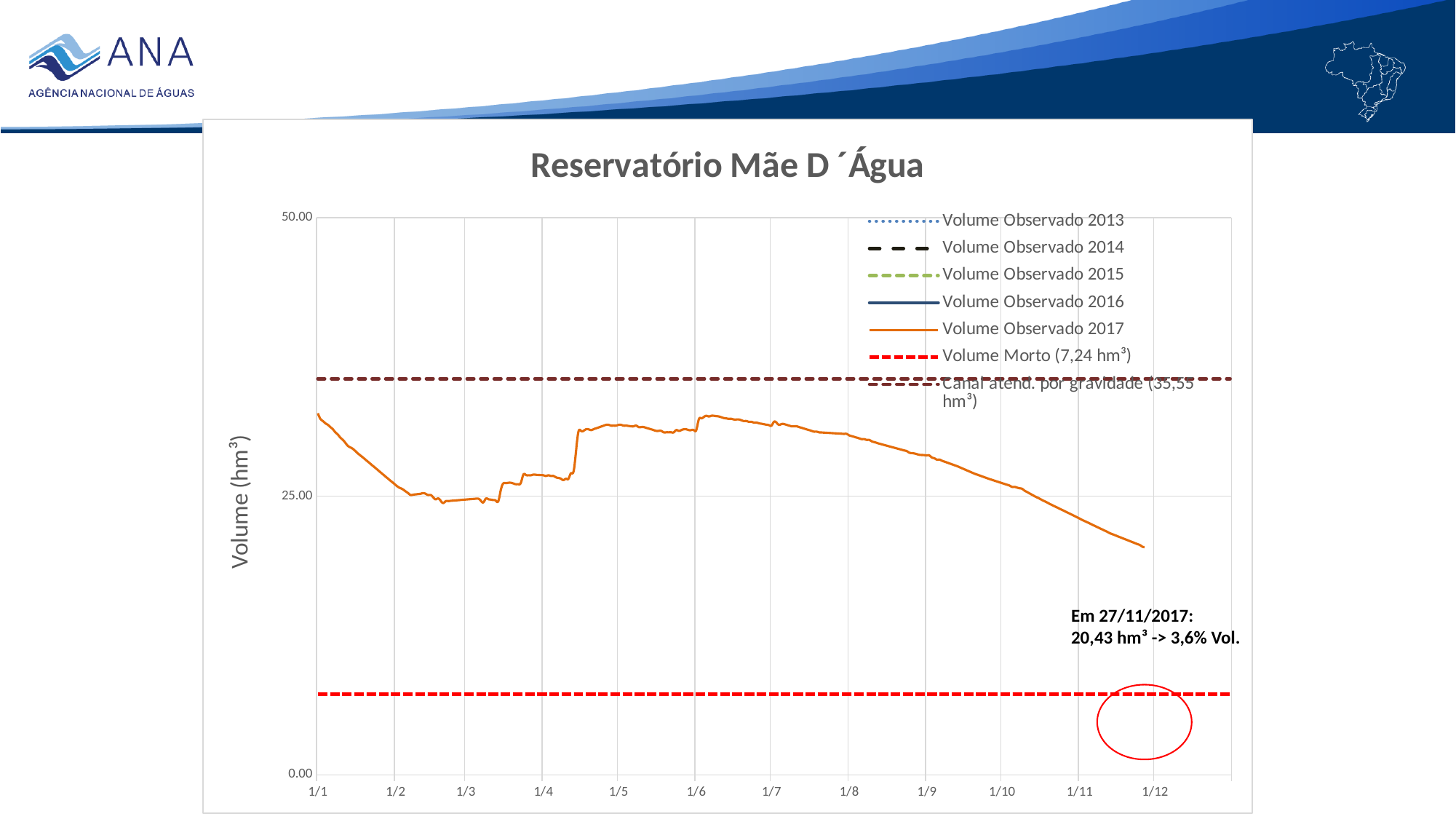
What is the title of the chart? Reservatório Mãe D´Água What is the value of the Canal atend. por gravidade line given in the legend? 35,55 hm³ Is the Volume Observado 2017 value at 1/1 greater or less than 25.00? greater What was the observed volume on 27/11/2017 according to the annotation? 20,43 hm³ What is the Volume Morto value given in the legend? 7,24 hm³ Which line is higher on the chart, Canal atend. por gravidade or Volume Morto? Canal atend. por gravidade What percentage of volume does the annotation give for 27/11/2017? 3,6% What colour is the Volume Observado 2017 line? orange Is the Volume Observado 2017 value at 1/12 greater or less than 25.00? less Does the Volume Observado 2017 line rise or fall between 1/6 and 1/12? fall How many series does the chart legend list? 7 What kind of chart is shown on the slide? line chart